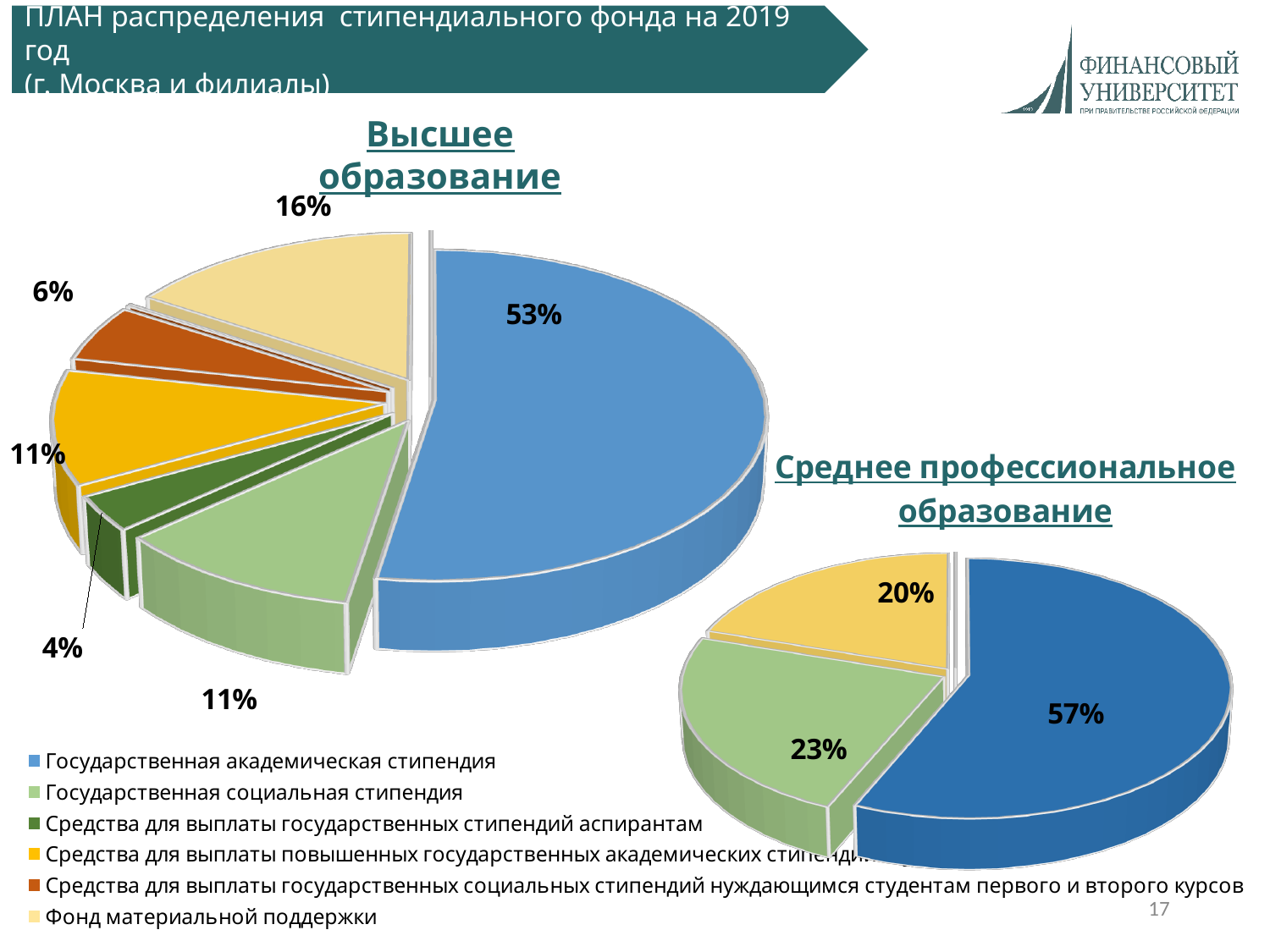
In the "Высшее образование" chart, which category has the largest share? Государственная академическая стипендия Which chart shows a larger share for Государственная академическая стипендия, "Высшее образование" or "Среднее профессиональное образование"? Среднее профессиональное образование In the "Высшее образование" chart, which category has the smallest share? Средства для выплаты государственных стипендий аспирантам In the "Среднее профессиональное образование" chart, what share is Государственная социальная стипендия? 23% What kind of chart is used for "Высшее образование"? pie chart In the "Среднее профессиональное образование" chart, what share is Государственная академическая стипендия? 57% In the "Высшее образование" chart, what share is Фонд материальной поддержки? 16% How many entries does the legend list? 6 How many slices does the "Среднее профессиональное образование" pie chart have? 3 In the "Высшее образование" chart, what share is Государственная академическая стипендия? 53% In the "Высшее образование" chart, what is the difference in percentage points between Государственная академическая стипендия and Фонд материальной поддержки? 37 percentage points